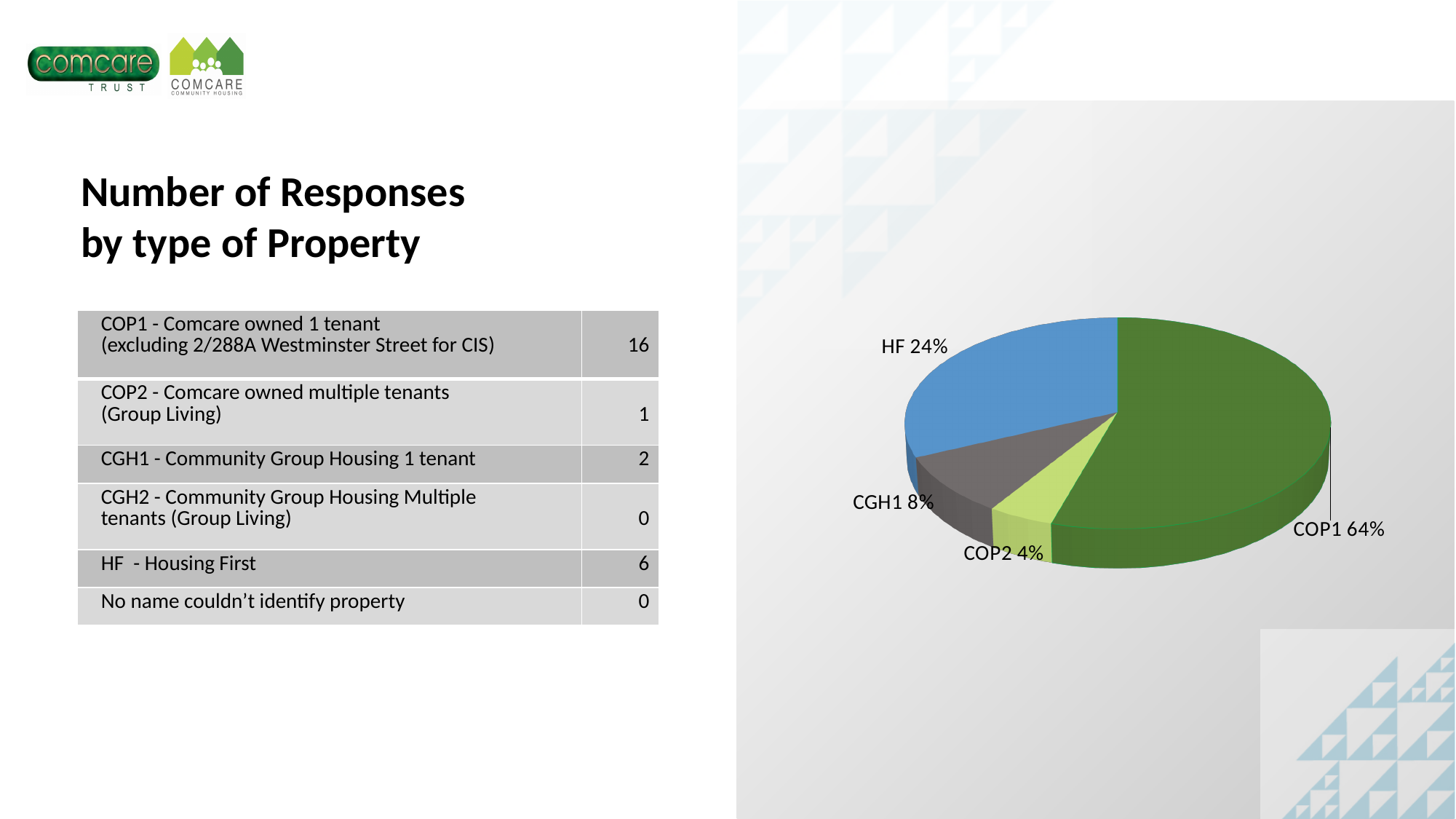
Which slice of the pie chart is the largest? COP1 How many slices are labelled in the pie chart? 4 What share of the pie does COP1 have? 64% What share of the pie does HF have? 24% What is the difference in percentage points between the COP1 and HF slices? 40 What colour is the COP1 slice of the pie chart? green What share of the pie does CGH1 have? 8% What is the difference in percentage points between the CGH1 and COP2 slices? 4 Which slice of the pie chart is the smallest? COP2 Which slice is larger, HF or CGH1? HF What kind of chart is shown on the slide? pie chart